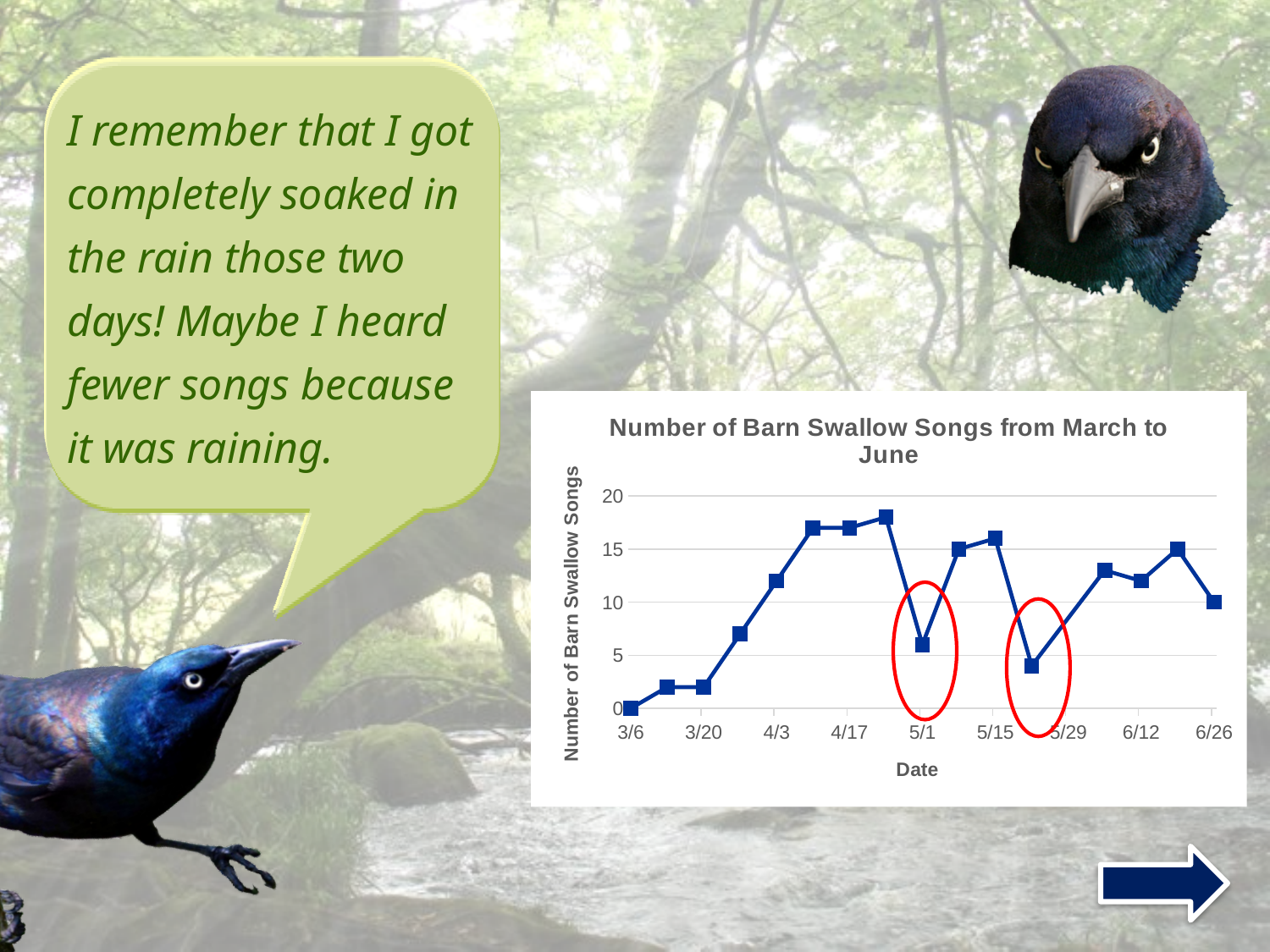
What is the label of the y axis? Number of Barn Swallow Songs Is the value for 6/26 greater or less than 15? less What is the title of the chart? Number of Barn Swallow Songs from March to June Is the value for 4/17 greater or less than 15? greater Is the value for 5/1 greater or less than 10? less What is the number of Barn Swallow songs on 3/6? 0 Which date has the lowest number of Barn Swallow songs? 3/6 How many date labels are shown on the x axis? 9 Which date has the higher number of songs, 4/17 or 5/1? 4/17 What kind of chart is shown on the slide? line chart Do the values rise or fall from 3/6 to 4/17? rise